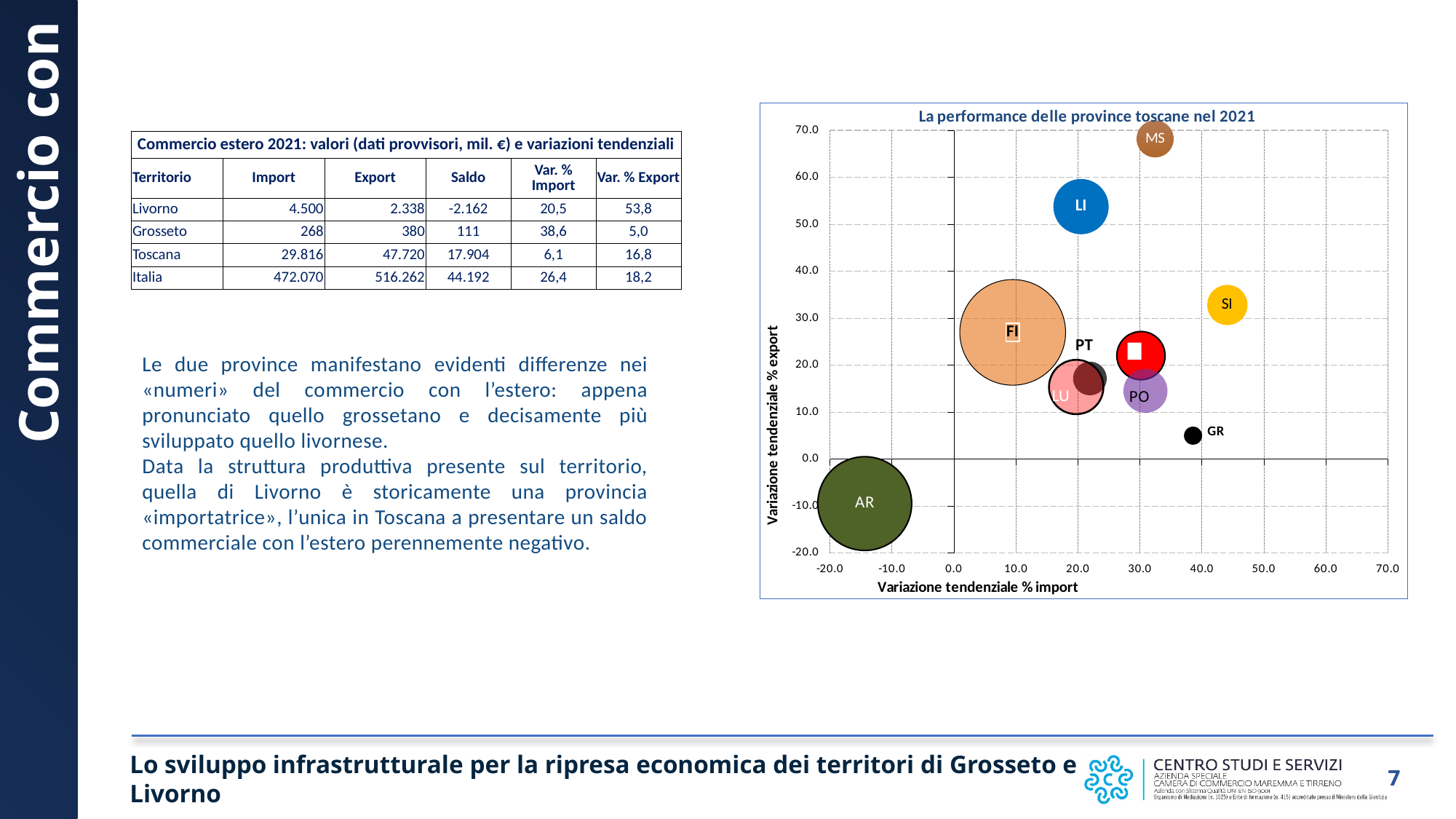
What kind of chart is shown on the slide? bubble chart Which has a higher Variazione tendenziale % export, LI or SI? LI Is the Variazione tendenziale % export for MS greater or less than 60.0? greater Which province has the lowest Variazione tendenziale % export in the chart? AR Is the Variazione tendenziale % export for AR greater or less than 0.0? less Is the Variazione tendenziale % import for SI greater or less than 40.0? greater What is the label of the horizontal axis of the chart? Variazione tendenziale % import Which has a higher Variazione tendenziale % import, GR or FI? GR What is the title of the chart on the slide? La performance delle province toscane nel 2021 Which province has the lowest Variazione tendenziale % import in the chart? AR Which province has the highest Variazione tendenziale % export in the chart? MS